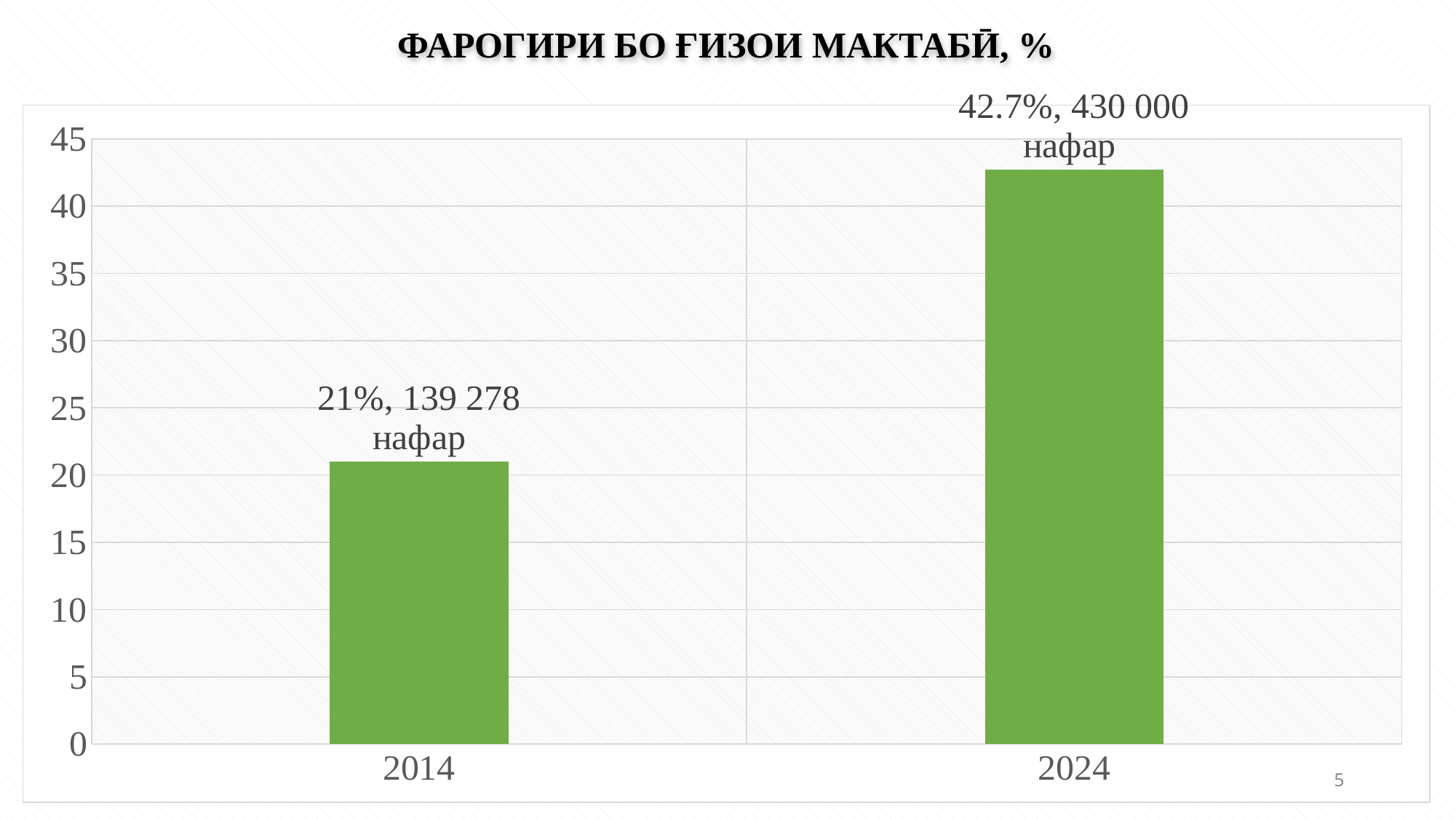
What is the title of the chart? ФАРОГИРИ БО ҒИЗОИ МАКТАБӢ, % Which year has the lower value? 2014 How many people (нафар) are shown for 2014? 139 278 Do the values rise or fall from 2014 to 2024? rise How many categories are shown on the x axis? 2 What kind of chart is this? bar chart What is the difference in percentage points between 2024 and 2014? 21.7 Which year has the higher value? 2024 Is the value for 2024 greater or less than 40? greater What percentage is shown for 2014? 21% What percentage is shown for 2024? 42.7% How many people (нафар) are shown for 2024? 430 000